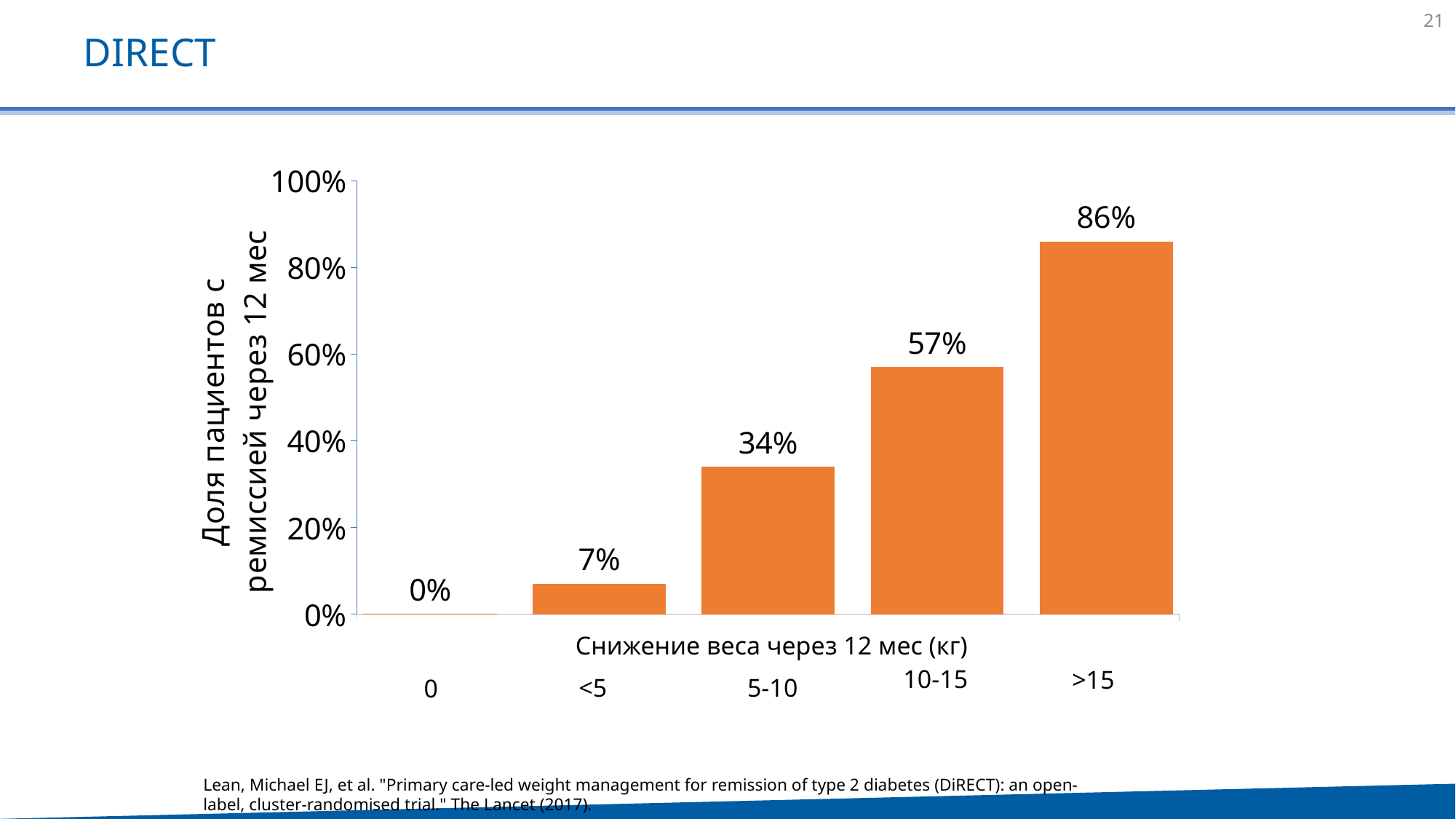
What is the share of patients in remission at 12 months for the weight loss category '<5' kg? 7% What is the difference in remission share between the '5-10' and '<5' weight loss categories? 27% What is the share of patients in remission at 12 months for the weight loss category '>15' kg? 86% What is the share of patients in remission at 12 months for the weight loss category '5-10' kg? 34% Which has a larger remission share: the '10-15' category or the '5-10' category? 10-15 How many weight loss categories are shown on the x axis? 5 Do the remission shares rise or fall as weight loss increases along the x axis? Rise What is the difference in remission share between the '>15' and '10-15' weight loss categories? 29% Which weight loss category has the lowest share of patients in remission? 0 What is the share of patients in remission at 12 months for the weight loss category '10-15' kg? 57% What kind of chart is shown on the slide? Bar chart Which weight loss category has the highest share of patients in remission? >15